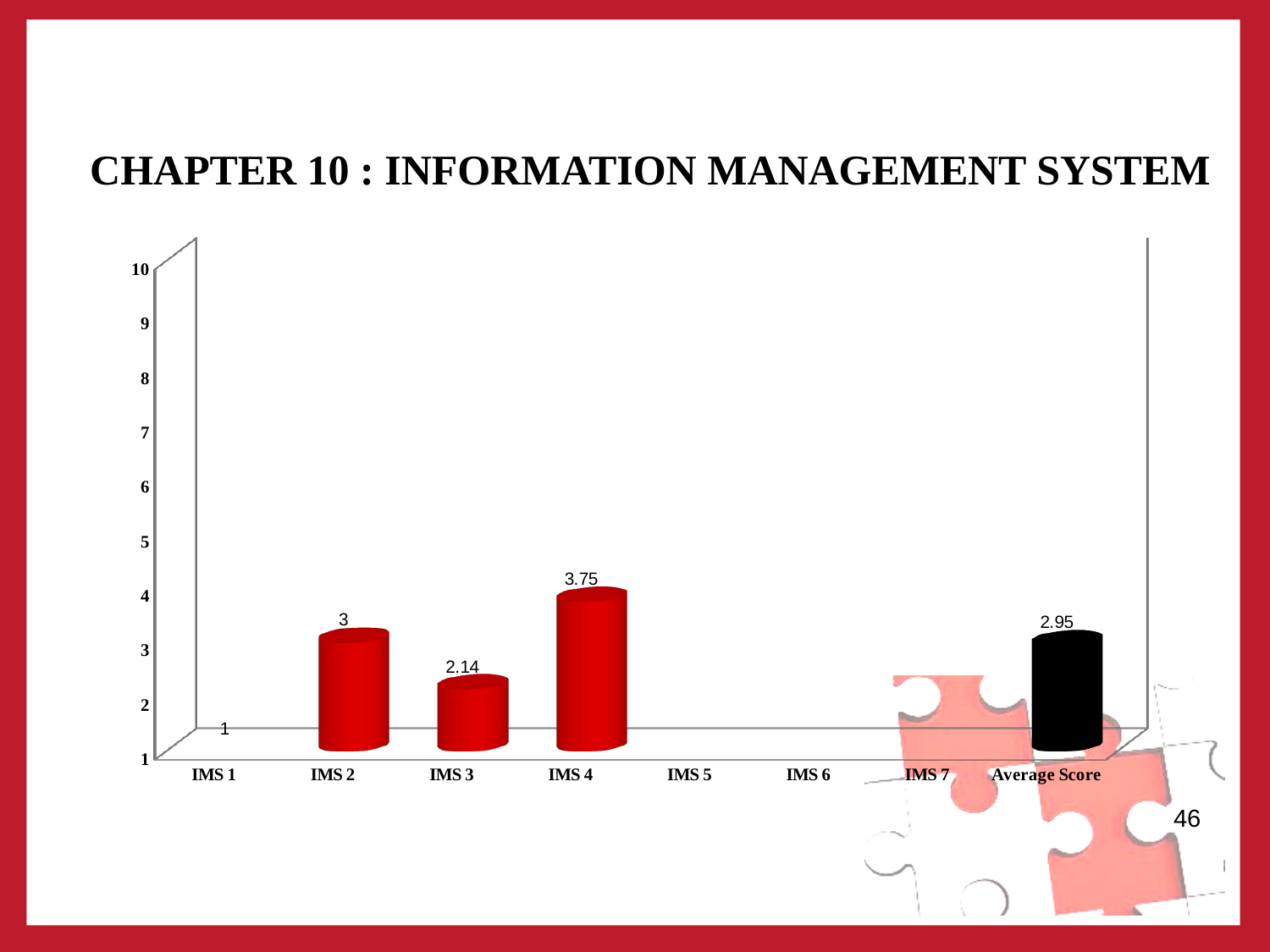
What colour is the Average Score bar? Black How many categories are listed along the x axis? 8 What is the difference between the Average Score and the value for IMS 3? 0.81 What is the value for IMS 2? 3 What is the value for IMS 4? 3.75 What is the difference between the values for IMS 4 and IMS 2? 0.75 Which category has the highest value? IMS 4 What kind of chart is shown on the slide? Bar chart What is the value for IMS 3? 2.14 Which of the labelled categories has the lowest value? IMS 1 Which is larger, the value for IMS 2 or the Average Score? IMS 2 What is the value shown for Average Score? 2.95